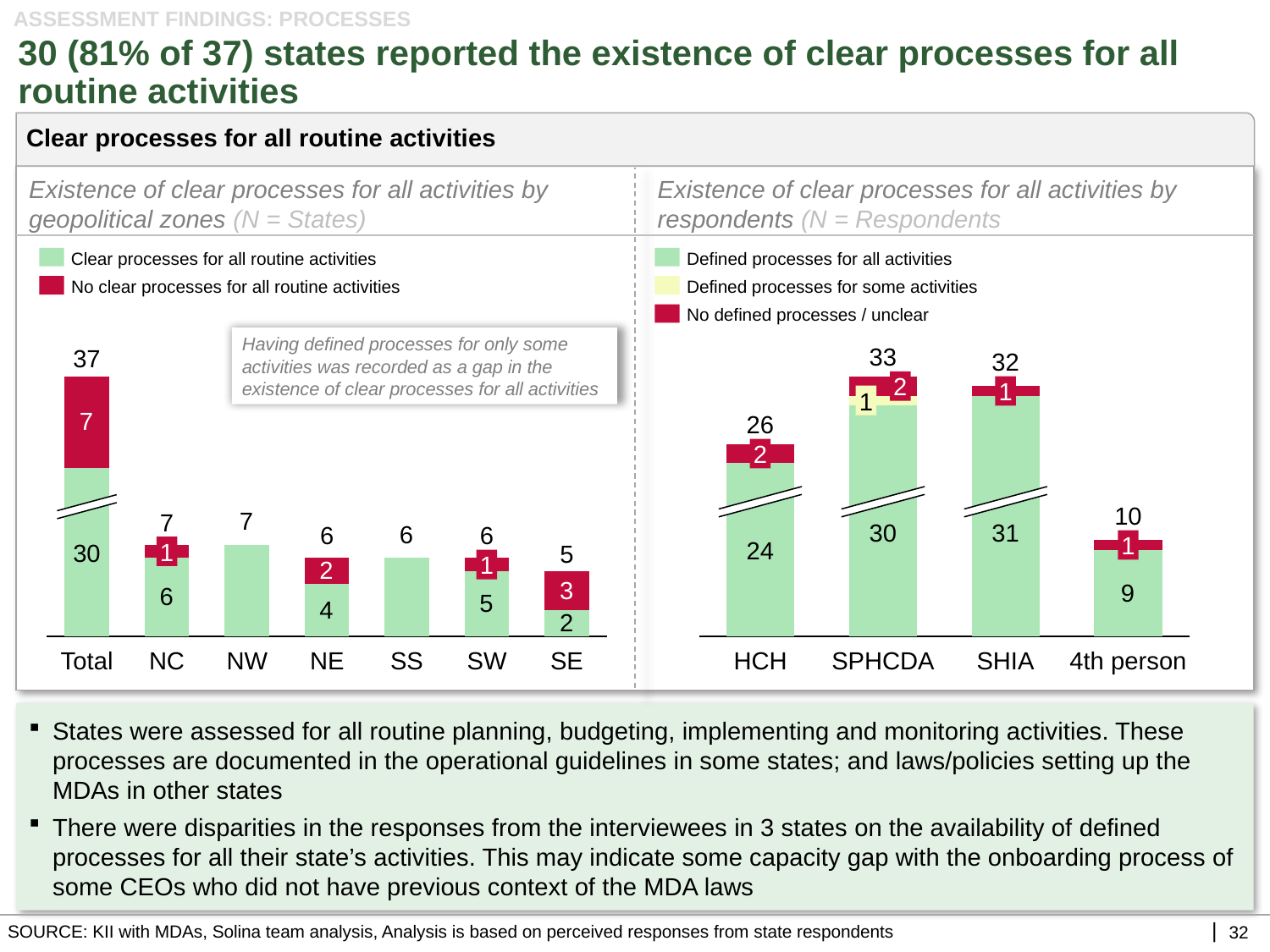
In the chart by geopolitical zones, what is the total number of states for the NE zone? 6 In the chart by geopolitical zones, excluding the Total bar, which zone has the lowest total? SE In the chart by respondents, which respondent group has the highest total? SPHCDA In the chart by respondents, how many SHIA respondents reported defined processes for all activities? 31 In the chart by geopolitical zones, what is the difference between the number of states with clear processes and without clear processes in the NE zone? 2 In the chart by geopolitical zones, how many states in the SE zone have no clear processes for all routine activities? 3 In the chart by respondents, what is the total number of respondents for SPHCDA? 33 In the chart by geopolitical zones, how many states in the Total bar have clear processes for all routine activities? 30 In the chart by respondents, which is larger: the total for HCH or the total for 4th person? HCH In the chart by geopolitical zones, how many zone categories are shown on the x axis, including Total? 7 What type of chart is used in the chart by respondents? Stacked bar chart In the chart by respondents, how many series does the legend list? 3